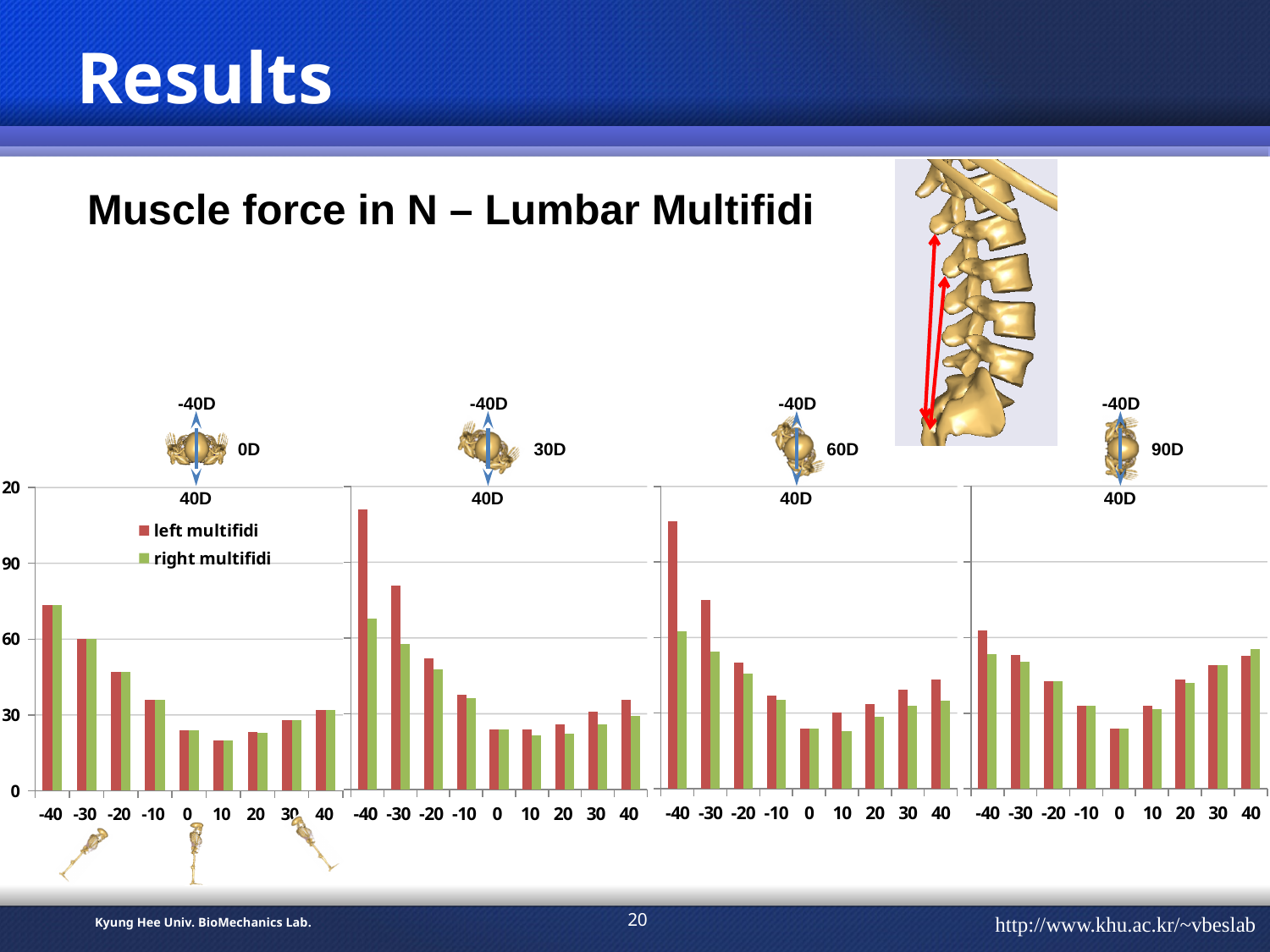
In the 30D chart, at -40, which is larger: left multifidi or right multifidi? left multifidi In the 30D chart, do the left multifidi values rise or fall from -40 to 0 along the x axis? fall How many series does the legend on the 0D chart list? 2 In the 90D chart, is the left multifidi value at 0 greater or less than 30? less In the 0D chart, which x-axis category has the lowest left multifidi value? 10 What kind of chart is used for the 0D panel? bar chart In the 60D chart, is the right multifidi value at 0 greater or less than 30? less In the 0D chart, which x-axis category has the highest left multifidi value? -40 Which colour represents right multifidi in the legend? green In the 0D chart, is the left multifidi value at -40 greater or less than 60? greater How many categories are shown on the x axis of the 30D chart? 9